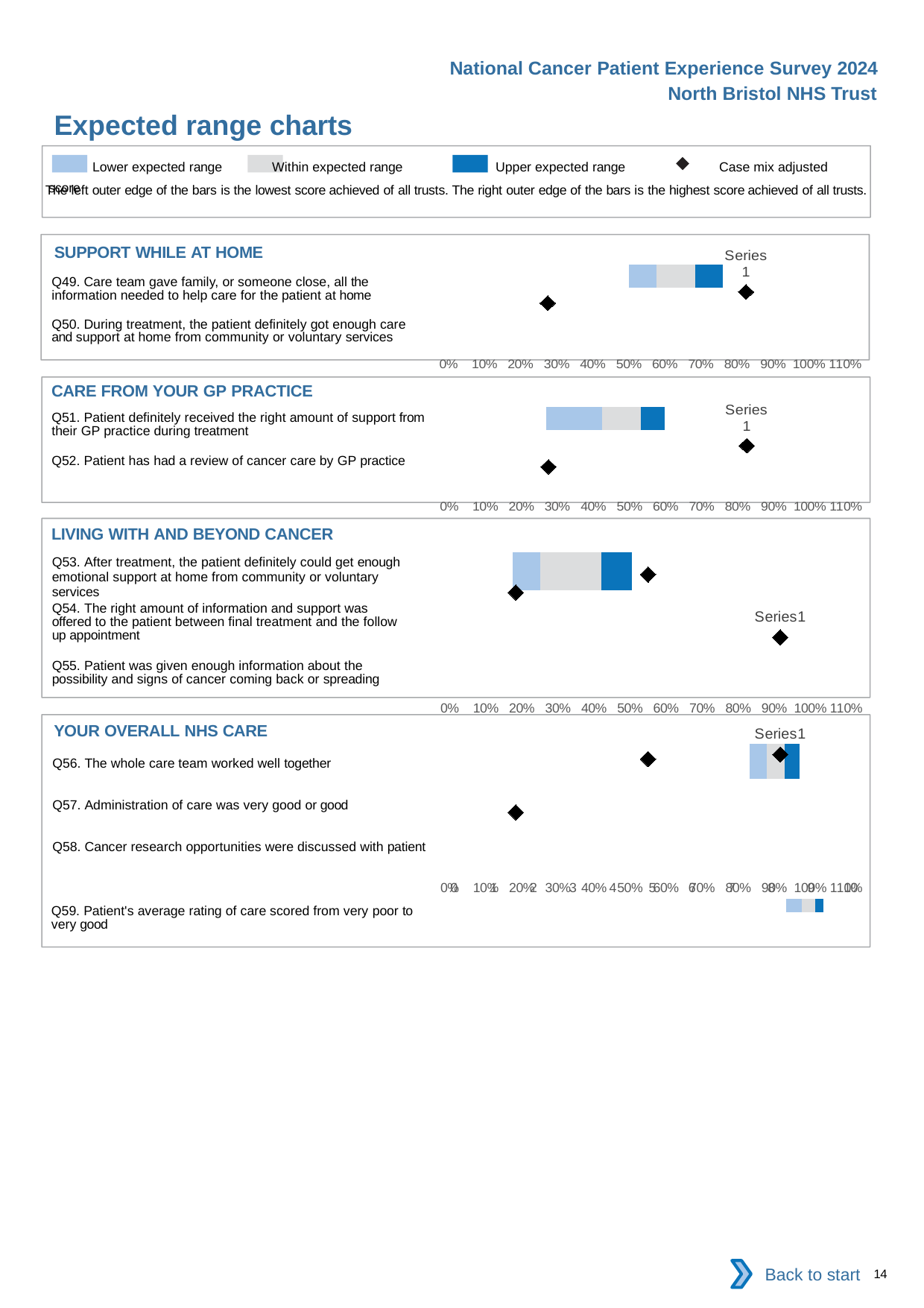
How many entries does the legend at the top of the slide list? 4 How many questions (categories) are listed in the 'SUPPORT WHILE AT HOME' chart? 2 According to the legend, which colour represents the upper expected range? dark blue What kind of chart is used in the 'SUPPORT WHILE AT HOME' section? bar chart In the 'YOUR OVERALL NHS CARE' chart, is the case mix adjusted score for Q56 greater or less than 40%? greater How many questions (categories) are listed in the 'YOUR OVERALL NHS CARE' chart? 4 In the 'YOUR OVERALL NHS CARE' chart, which has the larger case mix adjusted score, Q56 or Q57? Q56 How many questions (categories) are listed in the 'LIVING WITH AND BEYOND CANCER' chart? 3 What is the interval between consecutive ticks on the x axis of the 'LIVING WITH AND BEYOND CANCER' chart? 10% What is the highest tick shown on the x axis of the 'CARE FROM YOUR GP PRACTICE' chart? 110% In the 'CARE FROM YOUR GP PRACTICE' chart, is the case mix adjusted score for Q52 greater or less than 40%? less In the 'YOUR OVERALL NHS CARE' chart, is the case mix adjusted score for Q57 greater or less than 30%? less